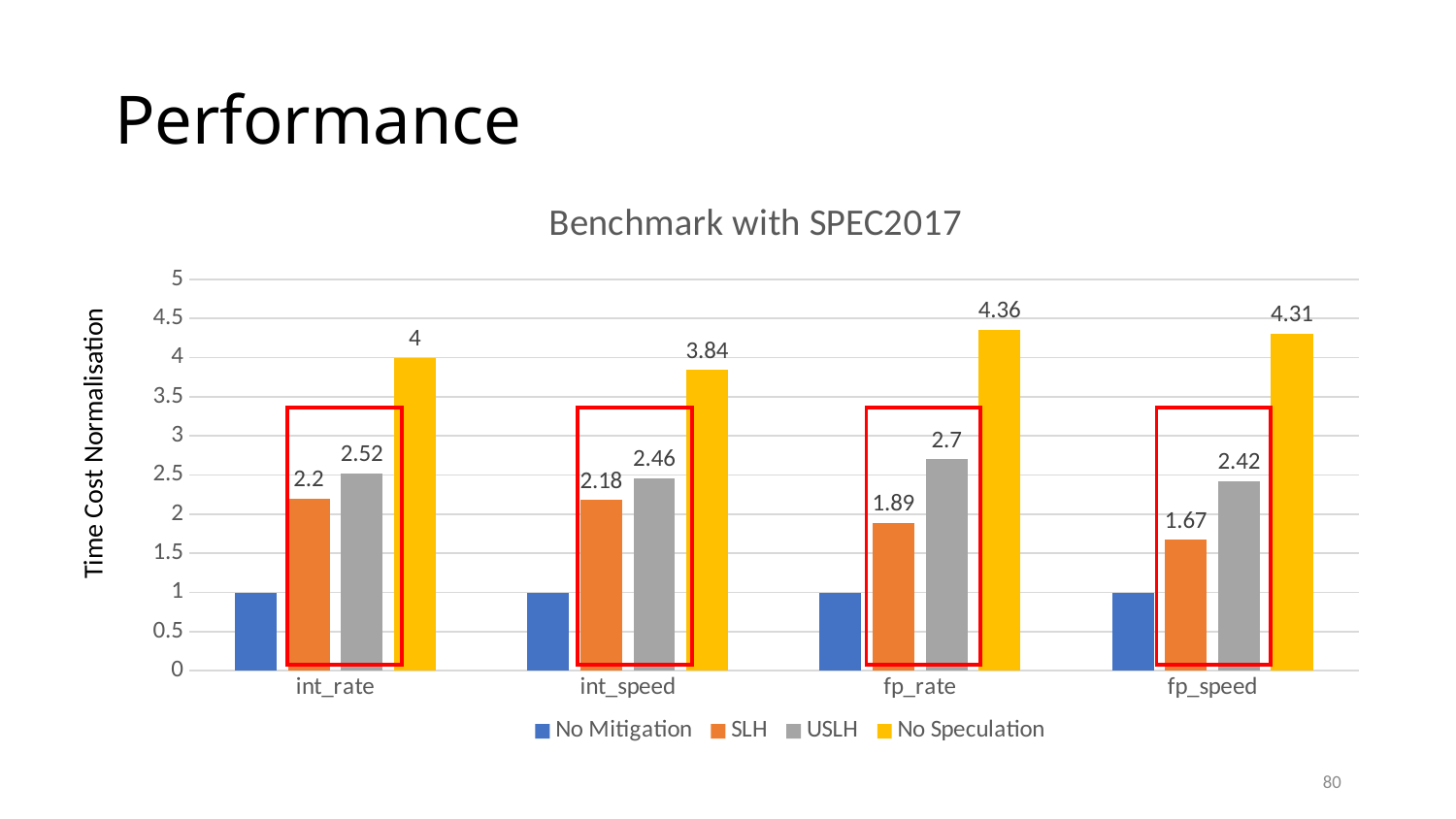
Is the No Mitigation value for int_rate greater or less than 1.5? less What is the value of the No Speculation bar for int_speed? 3.84 Which category has the lowest SLH value? fp_speed What is the value of the SLH bar for fp_rate? 1.89 Which is larger, the USLH value for fp_rate or the USLH value for int_speed? USLH value for fp_rate Which category has the highest No Speculation value? fp_rate What is the value of the USLH bar for fp_speed? 2.42 What is the difference between the USLH and SLH values for int_rate? 0.32 What kind of chart is shown on the slide? bar chart How many categories are shown on the x axis? 4 What is the label of the y axis? Time Cost Normalisation How many series does the legend list? 4